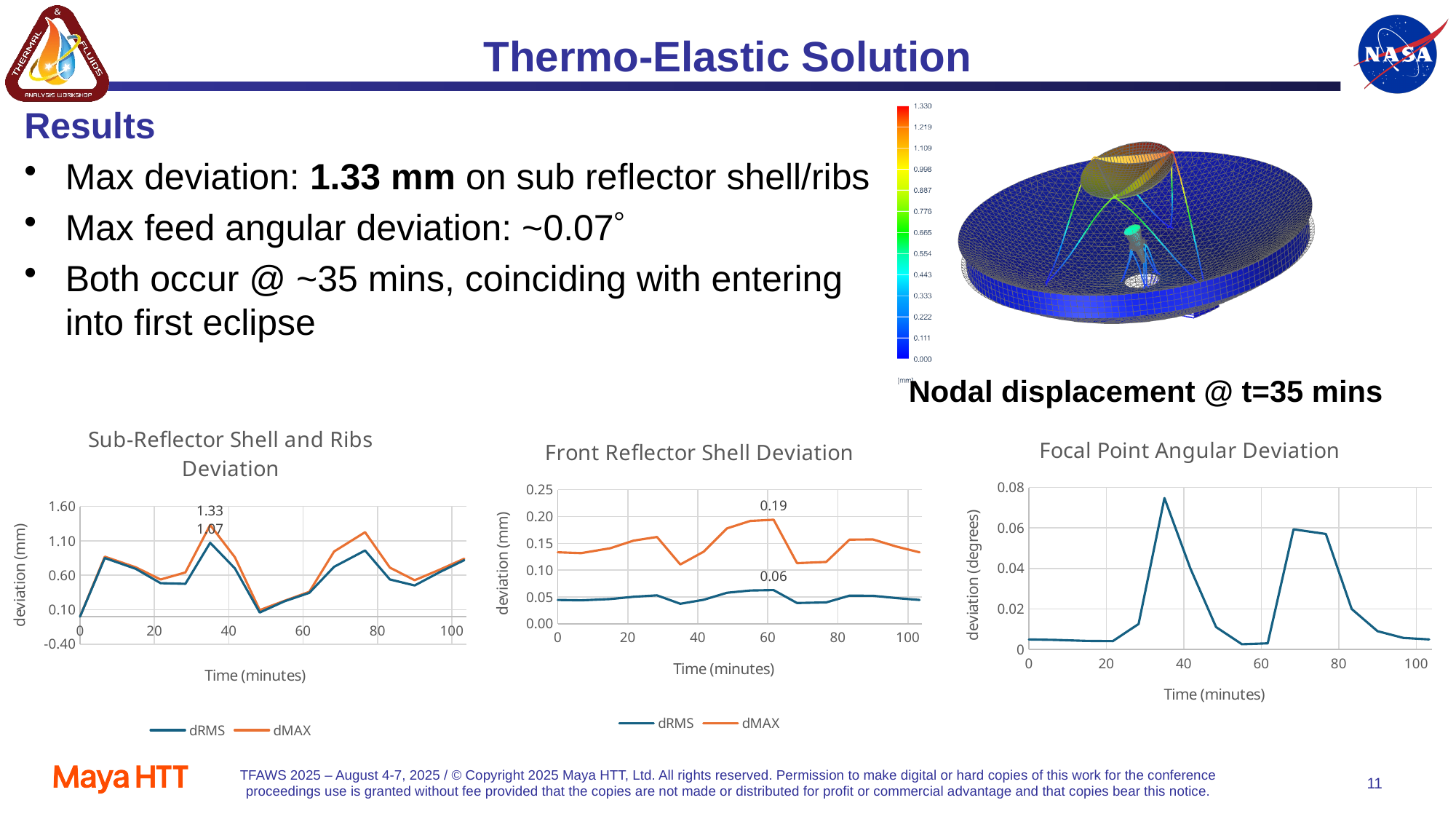
In the 'Sub-Reflector Shell and Ribs Deviation' chart, what is the labelled peak value of the dMAX series? 1.33 In the 'Front Reflector Shell Deviation' chart, is the dMAX value at time 0 greater or less than 0.15? less In the 'Sub-Reflector Shell and Ribs Deviation' chart, what is the labelled peak value of the dRMS series? 1.07 What is the x-axis label of the 'Focal Point Angular Deviation' chart? Time (minutes) What kind of chart is the 'Sub-Reflector Shell and Ribs Deviation' chart? line chart How many series does the legend of the 'Front Reflector Shell Deviation' chart list? 2 In the 'Front Reflector Shell Deviation' chart, what is the labelled peak value of the dRMS series? 0.06 In the 'Focal Point Angular Deviation' chart, is the highest value of the line greater or less than 0.06? greater In the 'Sub-Reflector Shell and Ribs Deviation' chart, what is the difference between the labelled dMAX peak and the labelled dRMS peak? 0.26 In the 'Front Reflector Shell Deviation' chart, what is the difference between the labelled dMAX peak and the labelled dRMS peak? 0.13 In the 'Front Reflector Shell Deviation' chart, what is the labelled peak value of the dMAX series? 0.19 In the 'Sub-Reflector Shell and Ribs Deviation' chart, which series reaches the higher labelled peak, dRMS or dMAX? dMAX